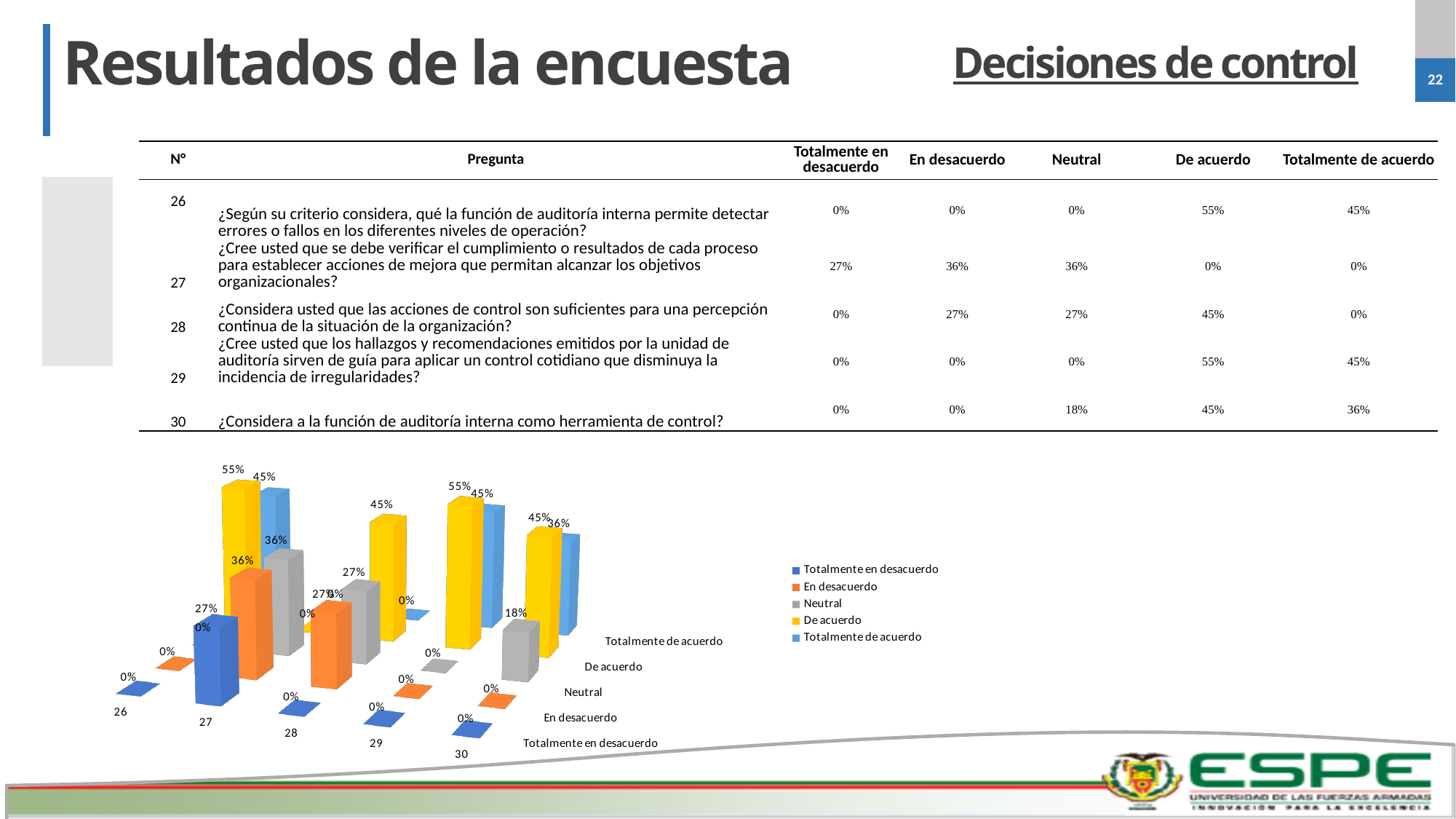
What kind of chart is shown on the slide? bar chart Which question has the lowest value for the "Neutral" series in the chart? 26 and 29 (both 0%) What is the value of "Neutral" for question 30 in the chart? 18% How many series does the chart legend list? 5 What is the value of "Totalmente de acuerdo" for question 29 in the chart? 45% What is the difference between the "De acuerdo" and "Totalmente de acuerdo" values for question 30? 9% Which colour represents the "Neutral" series in the chart legend? grey For question 28, which is larger: "De acuerdo" or "En desacuerdo"? De acuerdo What is the value of "De acuerdo" for question 26 in the chart? 55% How many question categories are plotted along the x axis of the chart? 5 Which question has the highest value for the "En desacuerdo" series in the chart? 27 What is the value of "Totalmente en desacuerdo" for question 27 in the chart? 27%